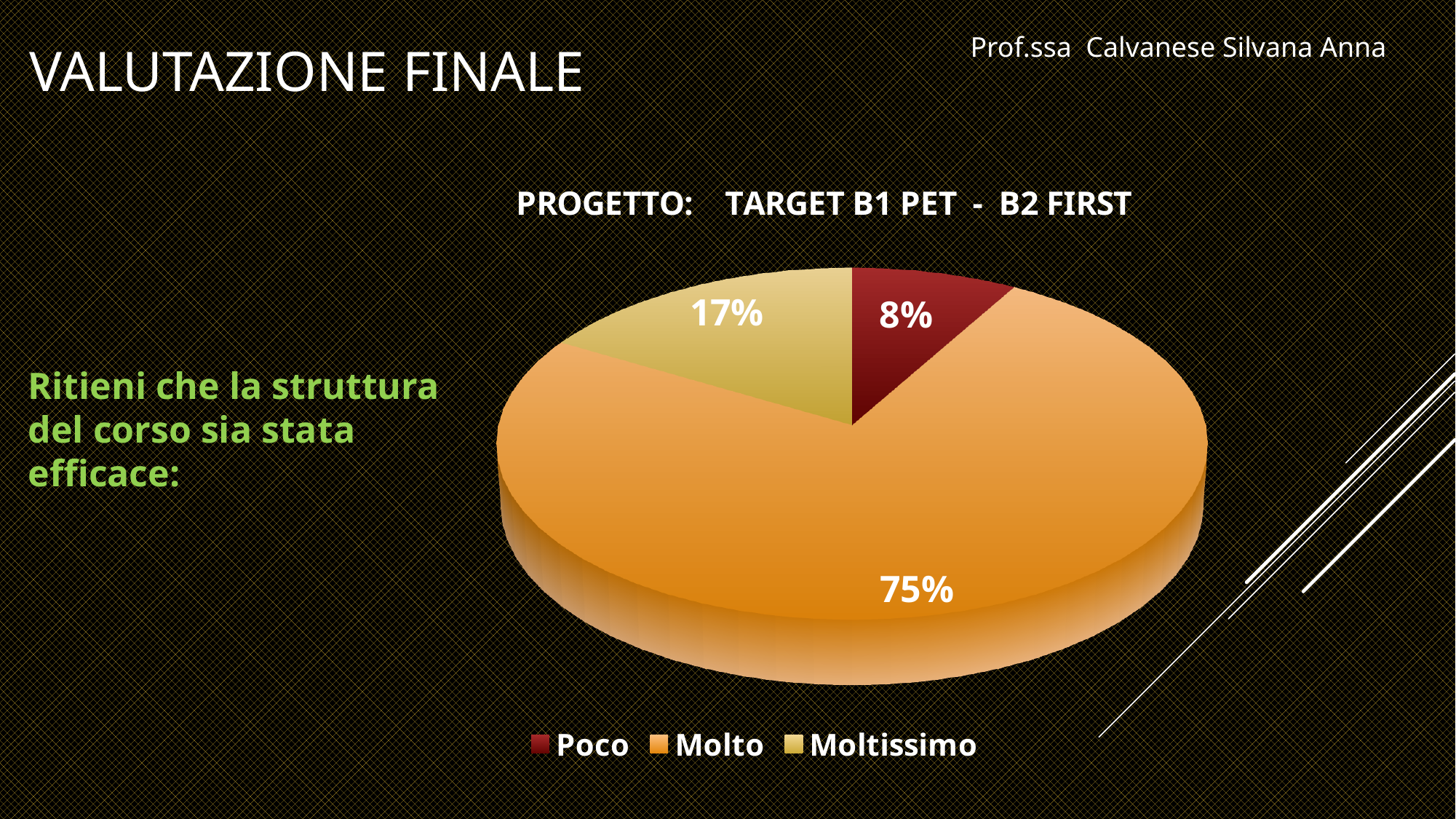
Which category has the smallest share of the pie? Poco What percentage of the pie is labelled Molto? 75% How many entries does the legend list? 3 What colour is the Poco slice in the pie chart? dark red Which is larger, the share for Moltissimo or the share for Poco? Moltissimo What kind of chart is shown on the slide? pie chart What percentage of the pie is labelled Moltissimo? 17% What is the title shown above the pie chart? PROGETTO: TARGET B1 PET - B2 FIRST How many slices does the pie chart have? 3 What percentage of the pie is labelled Poco? 8% What is the difference in percentage points between Molto and Moltissimo? 58 Which category has the largest share of the pie? Molto